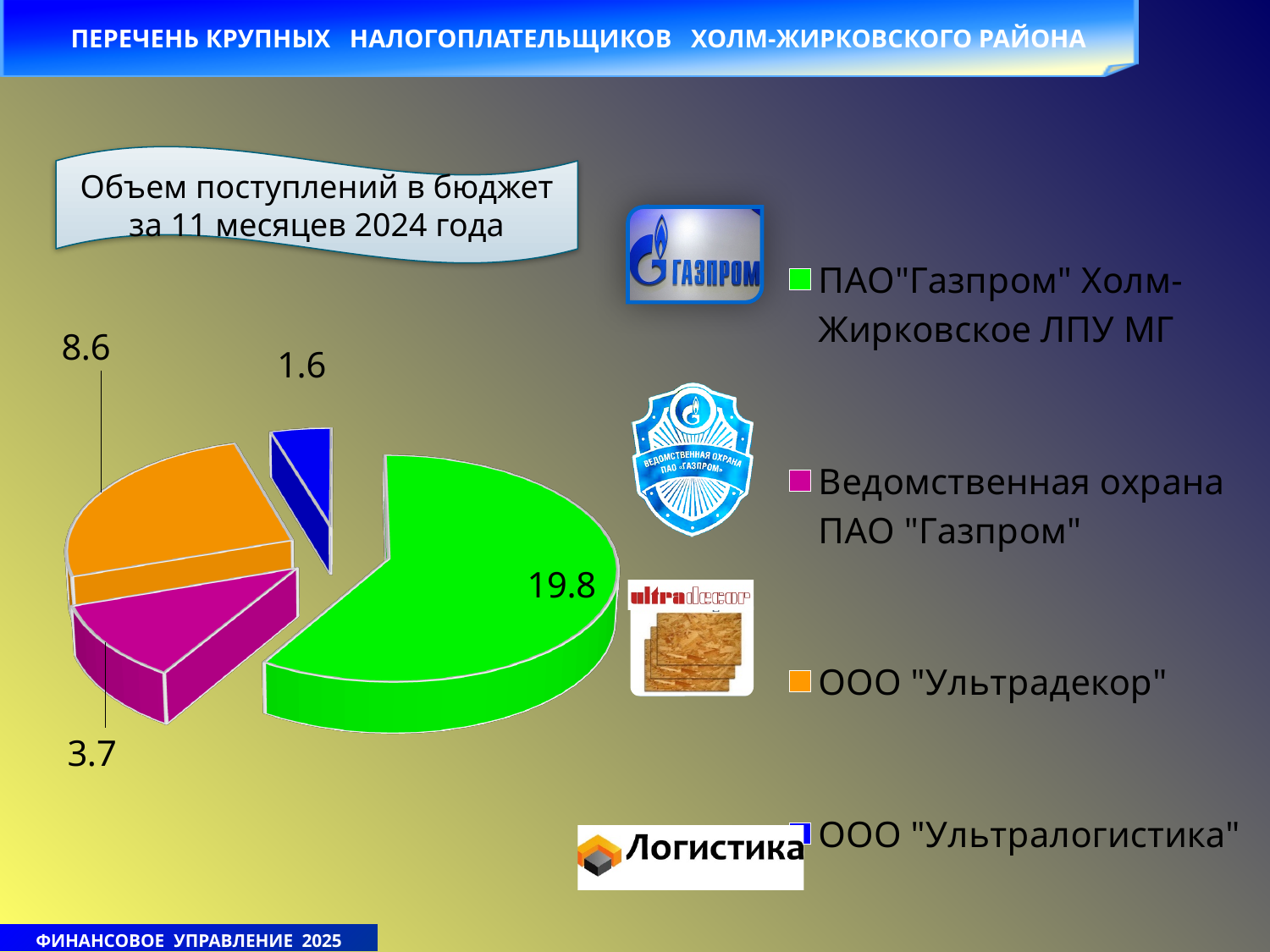
What value is shown for Ведомственная охрана ПАО "Газпром" in the pie chart? 3.7 Which taxpayer has the largest slice in the pie chart? ПАО "Газпром" Холм-Жирковское ЛПУ МГ Which taxpayer has the smallest slice in the pie chart? ООО "Ультралогистика" How many entries does the chart legend list? 4 What is the difference between the values for ПАО "Газпром" Холм-Жирковское ЛПУ МГ and ООО "Ультрадекор"? 11.2 What type of chart is shown on the slide? Pie chart What value is shown for ПАО "Газпром" Холм-Жирковское ЛПУ МГ in the pie chart? 19.8 What colour is the slice for ООО "Ультрадекор"? Orange How many slices does the pie chart have? 4 What value is shown for ООО "Ультралогистика" in the pie chart? 1.6 What value is shown for ООО "Ультрадекор" in the pie chart? 8.6 Which is larger: the value for ООО "Ультрадекор" or for Ведомственная охрана ПАО "Газпром"? ООО "Ультрадекор"